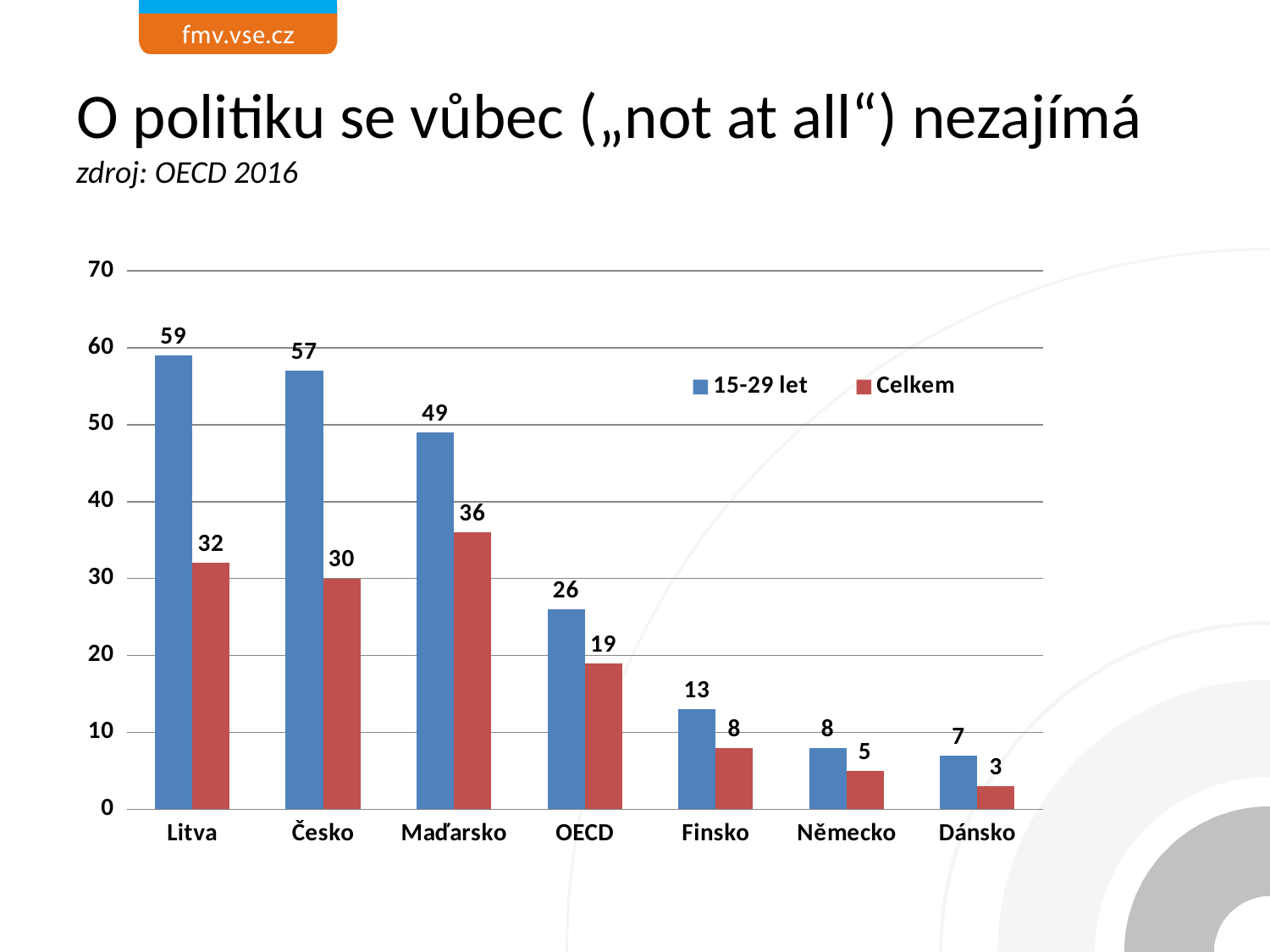
What kind of chart is shown on the slide? Bar chart Which is larger: the 15-29 let value for Finsko or the Celkem value for OECD? Celkem value for OECD How many categories are shown on the x axis? 7 What is the value for OECD in the Celkem series? 19 What source is cited below the slide title? OECD 2016 Which category has the lowest value in the Celkem series? Dánsko How many series does the legend list? 2 Which category has the highest value in the 15-29 let series? Litva Do the 15-29 let values rise or fall from Litva to Dánsko along the x axis? Fall What is the difference between the 15-29 let and Celkem values for Česko? 27 What is the Celkem value for Maďarsko? 36 What is the value for Litva in the 15-29 let series? 59